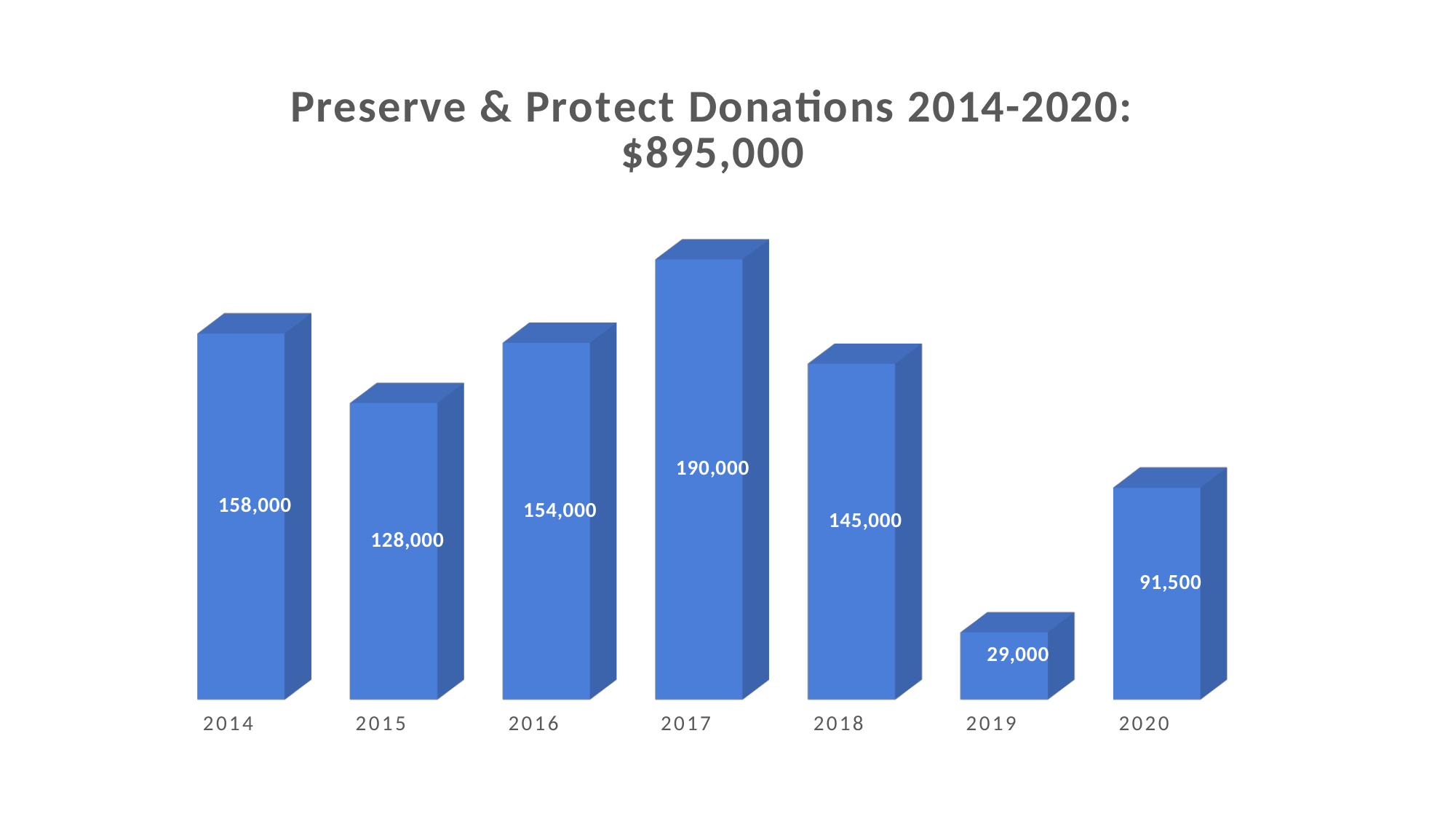
How many years are shown on the chart? 7 What total amount is stated in the chart title? $895,000 What is the difference between the donations in 2014 and 2015? 30,000 Which year had the lowest donations? 2019 What is the difference between the donations in 2017 and 2019? 161,000 What was the donation value for 2019? 29,000 Which year had larger donations, 2016 or 2018? 2016 What was the donation value for 2017? 190,000 Do donations rise or fall from 2017 to 2019? Fall Which year had the highest donations? 2017 What was the donation value for 2020? 91,500 What type of chart is shown on the slide? Bar chart